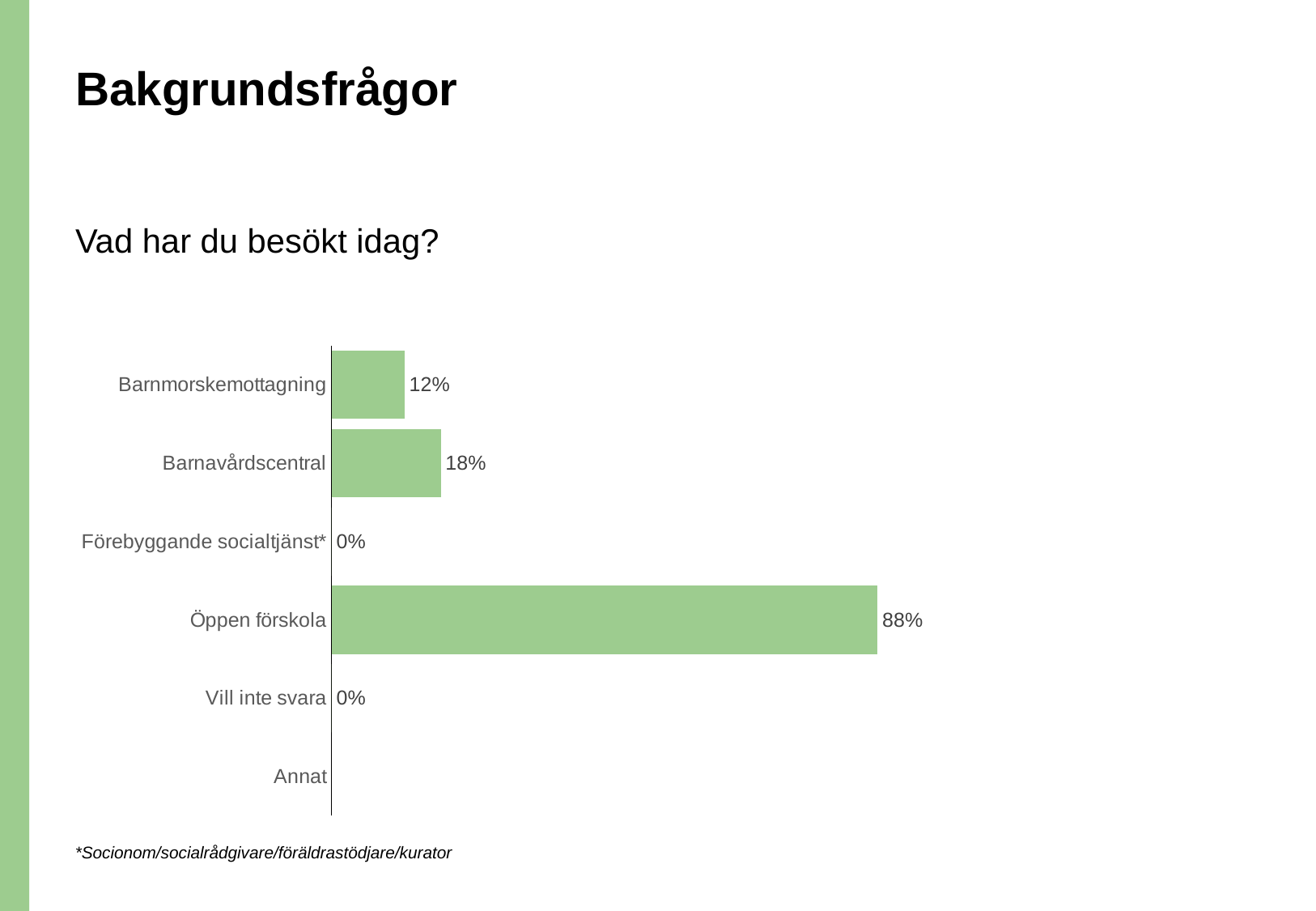
Which is larger, the value for Barnavårdscentral or the value for Barnmorskemottagning? Barnavårdscentral What is the difference between the values for Barnavårdscentral and Barnmorskemottagning? 6% What is the value for Barnmorskemottagning? 12% What is the difference between the values for Öppen förskola and Barnavårdscentral? 70% What is the value for Barnavårdscentral? 18% What is the value for Vill inte svara? 0% What is the value for Förebyggande socialtjänst*? 0% Which category has the highest value? Öppen förskola What is the value for Öppen förskola? 88% What question does the chart answer, according to the text above it? Vad har du besökt idag? What kind of chart is shown on the slide? Bar chart How many categories are shown on the chart? 6